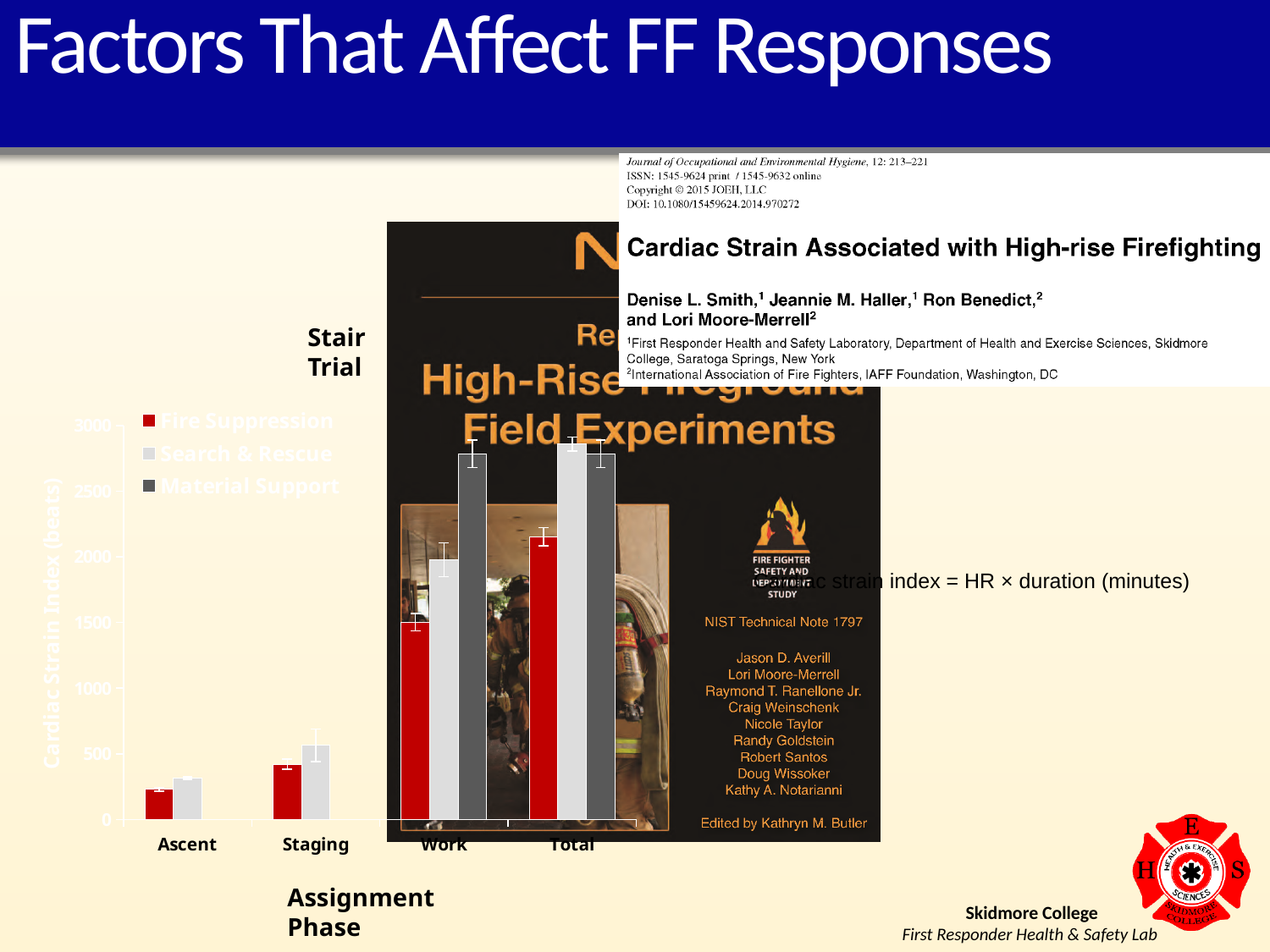
What is the label of the chart's y axis? Cardiac Strain Index (beats) What is the title of the chart? Stair Trial How many assignment phases are shown on the x axis of the chart? 4 For the Work phase, which is larger: the Fire Suppression value or the Material Support value? Material Support Is the Material Support value for Work greater or less than 2500? greater Which assignment phase has the lowest Fire Suppression value? Ascent How many series does the chart legend list? 3 Is the Fire Suppression value for Total greater or less than 2000? greater Do the Fire Suppression values rise or fall from Ascent to Total along the x axis? rise Is the Search & Rescue value for Total greater or less than 2500? greater What kind of chart is shown on the slide? bar chart